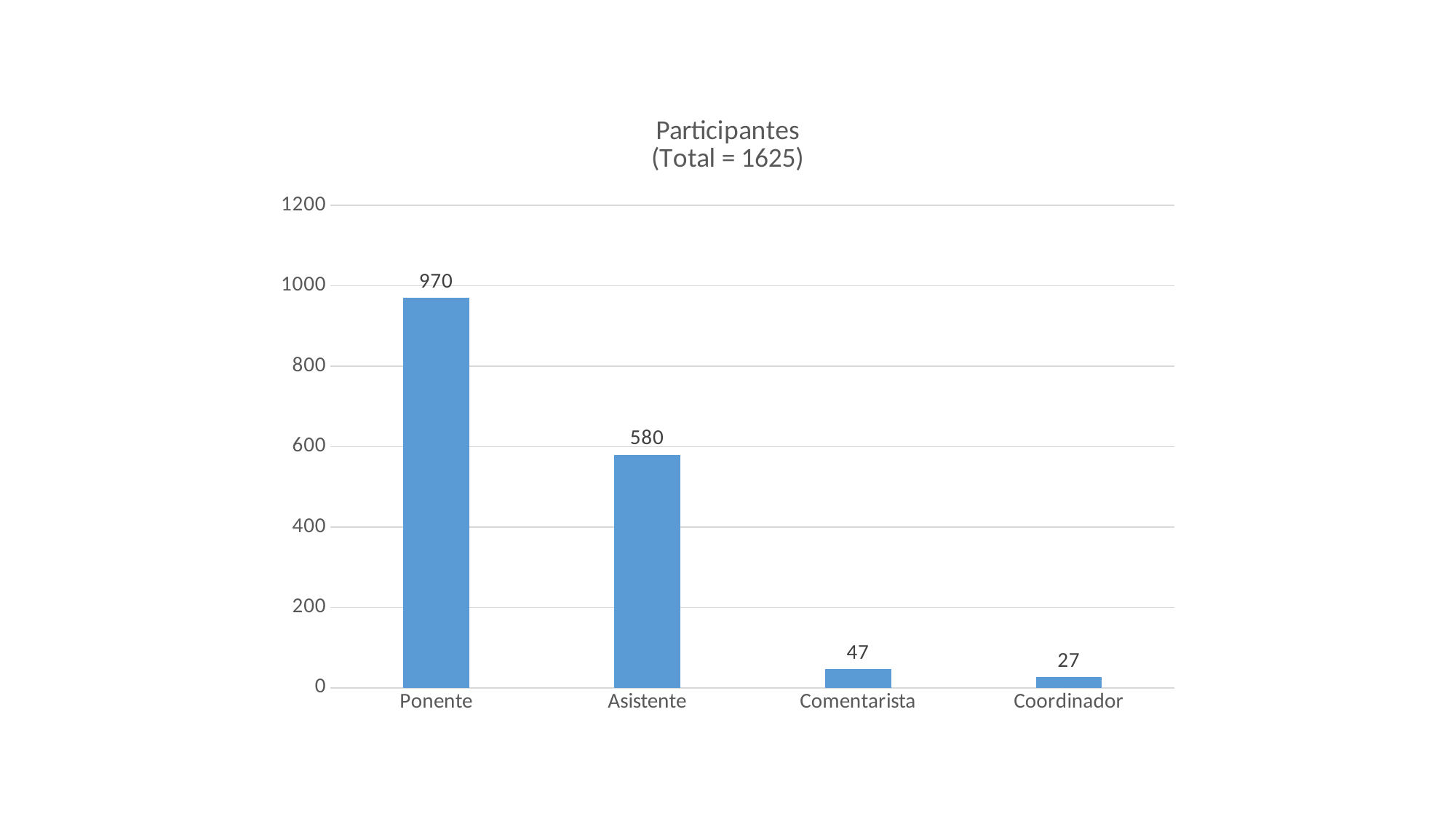
What total is stated in the chart title? 1625 What is the value for Asistente? 580 What is the difference between the values for Ponente and Asistente? 390 What is the value for Comentarista? 47 What is the value for Coordinador? 27 Which is larger, the value for Comentarista or the value for Coordinador? Comentarista What is the value for Ponente? 970 What kind of chart is shown on the slide? bar chart Is the value for Asistente greater or less than 600? less How many categories are shown on the x axis? 4 Which category has the highest value? Ponente Which category has the lowest value? Coordinador